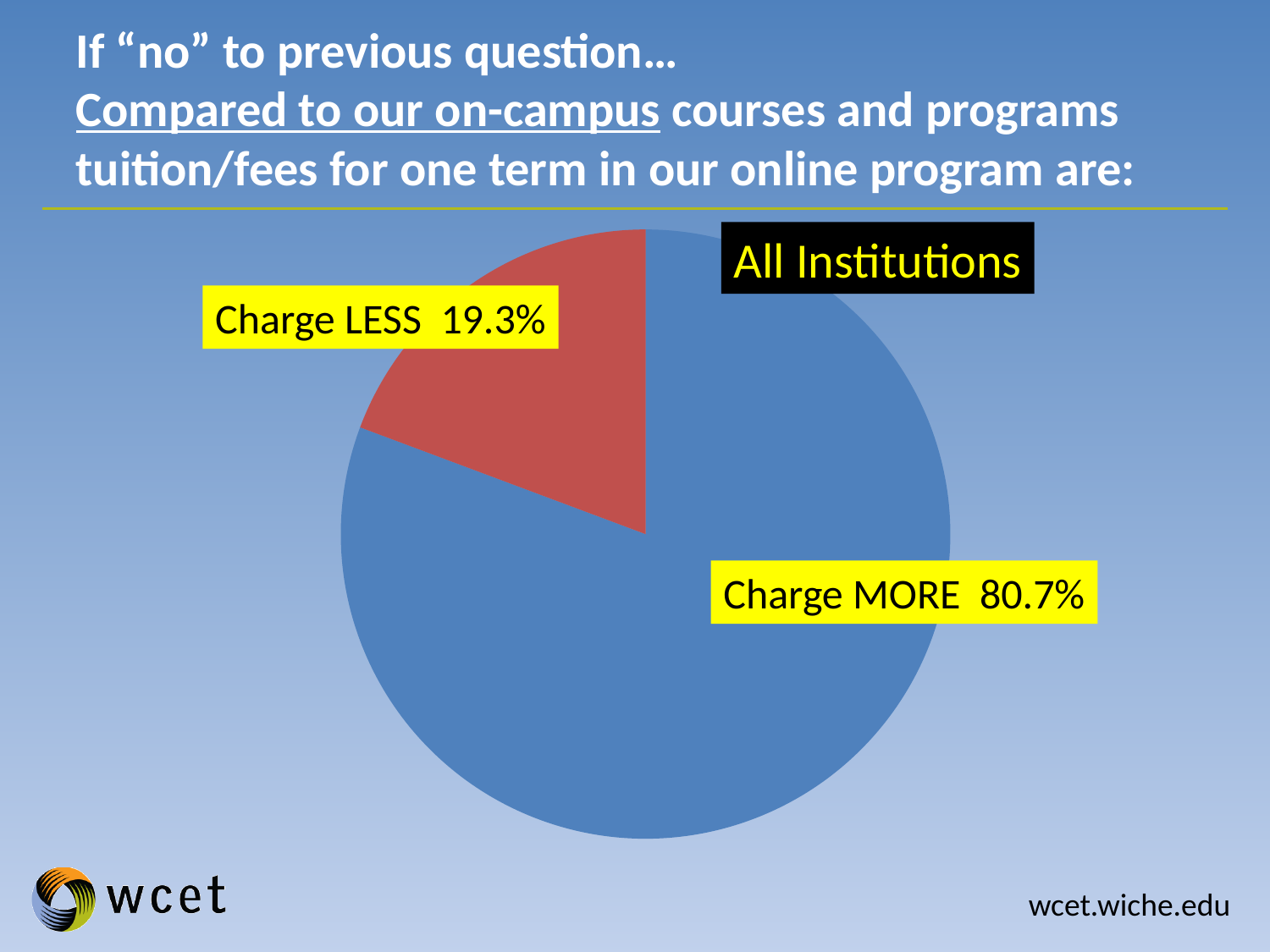
What colour is the Charge LESS slice of the pie? red What kind of chart is shown on the slide? pie chart Which category has the smallest share of the pie? Charge LESS How many slices does the pie chart have? 2 What is the difference in percentage points between Charge MORE and Charge LESS? 61.4 Which is larger, the share for Charge MORE or the share for Charge LESS? Charge MORE What percentage of institutions charge MORE for their online program compared to on-campus? 80.7% What percentage of institutions charge LESS for their online program compared to on-campus? 19.3% Is the share for Charge LESS greater or less than 25%? less Which category has the largest share of the pie? Charge MORE What group of institutions does the pie chart represent, according to the label on the chart? All Institutions